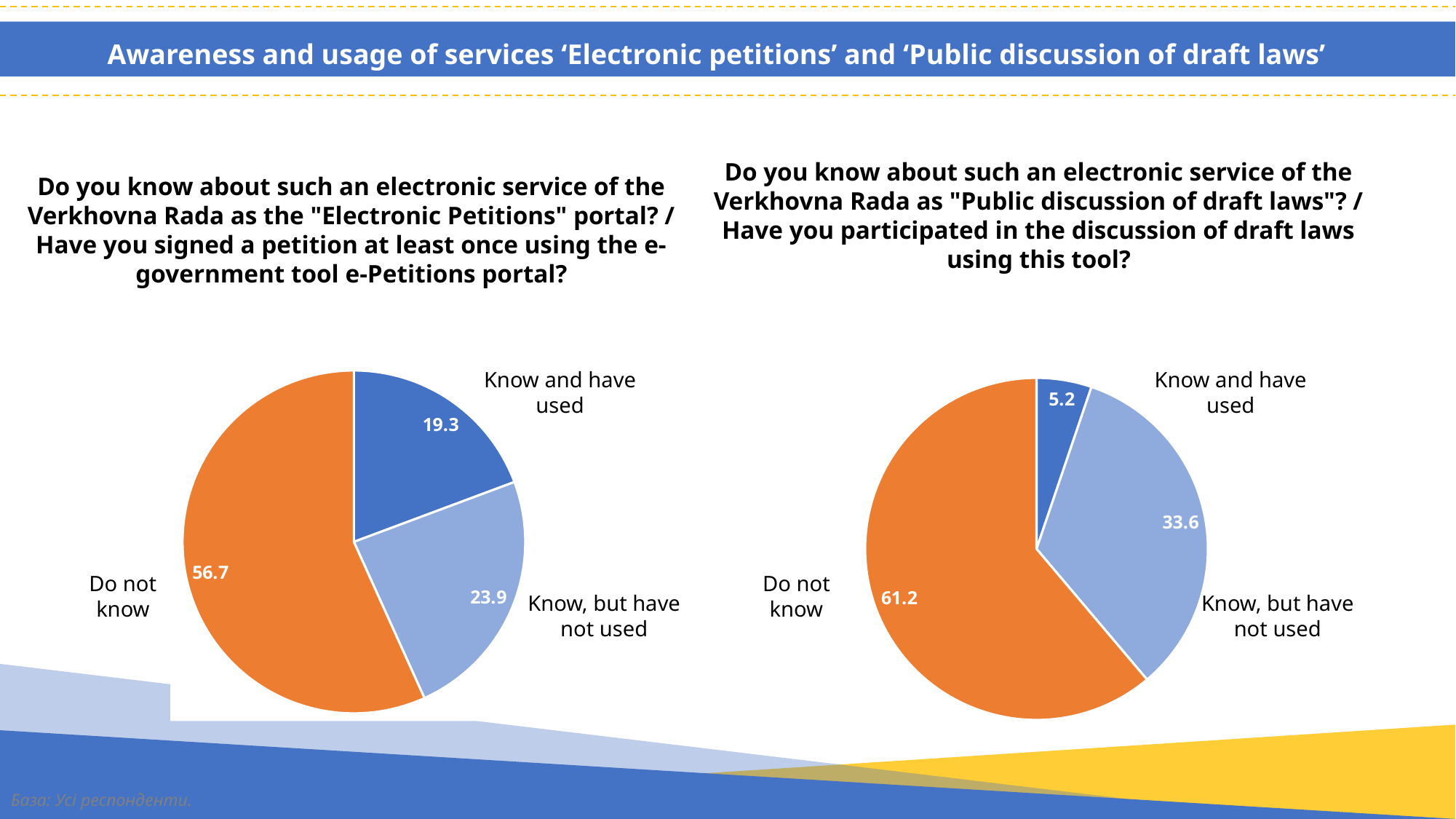
In the left pie chart (Electronic Petitions), what is the difference between 'Do not know' and 'Know, but have not used'? 32.8 In the right pie chart (Public discussion of draft laws), which category has the smallest slice? Know and have used Which chart has the larger value for 'Know and have used': the left pie chart (Electronic Petitions) or the right pie chart (Public discussion of draft laws)? The left pie chart (Electronic Petitions) What type of chart is used on the right side of the slide (Public discussion of draft laws)? Pie chart In the right pie chart (Public discussion of draft laws), what is the value for 'Know, but have not used'? 33.6 In the right pie chart (Public discussion of draft laws), what is the difference between 'Know, but have not used' and 'Know and have used'? 28.4 How many slices does the left pie chart (Electronic Petitions) have? 3 In the right pie chart (Public discussion of draft laws), what colour is the 'Do not know' slice? Orange In the left pie chart (Electronic Petitions), what is the value for 'Do not know'? 56.7 In the left pie chart (Electronic Petitions), which category has the largest slice? Do not know In the left pie chart (Electronic Petitions), what is the value for 'Know and have used'? 19.3 In the right pie chart (Public discussion of draft laws), what is the value for 'Know and have used'? 5.2